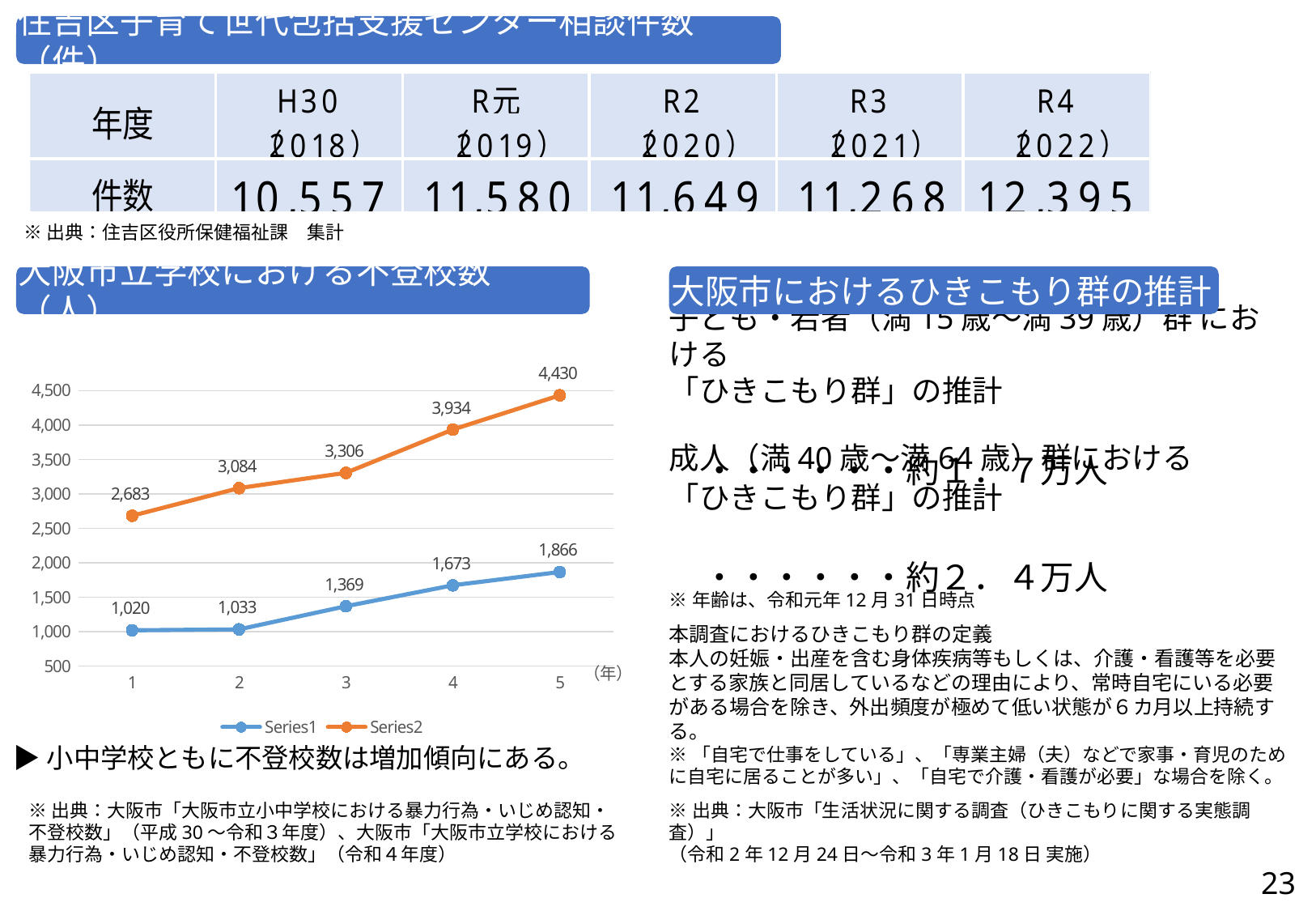
What is the difference between Series2 and Series1 at x = 5? 2,564 What is the value of Series2 at x = 5? 4,430 What is the value of Series1 at x = 1? 1,020 What is the value of Series1 at x = 4? 1,673 What kind of chart is shown on the slide? line chart How many x-axis points are plotted for each series? 5 Do the values of Series2 rise or fall from x = 1 to x = 5? rise What is the value of Series2 at x = 3? 3,306 At which x value is Series2 lowest? 1 Which is larger at x = 2: Series1 or Series2? Series2 How many series does the chart legend list? 2 At which x value is Series1 highest? 5